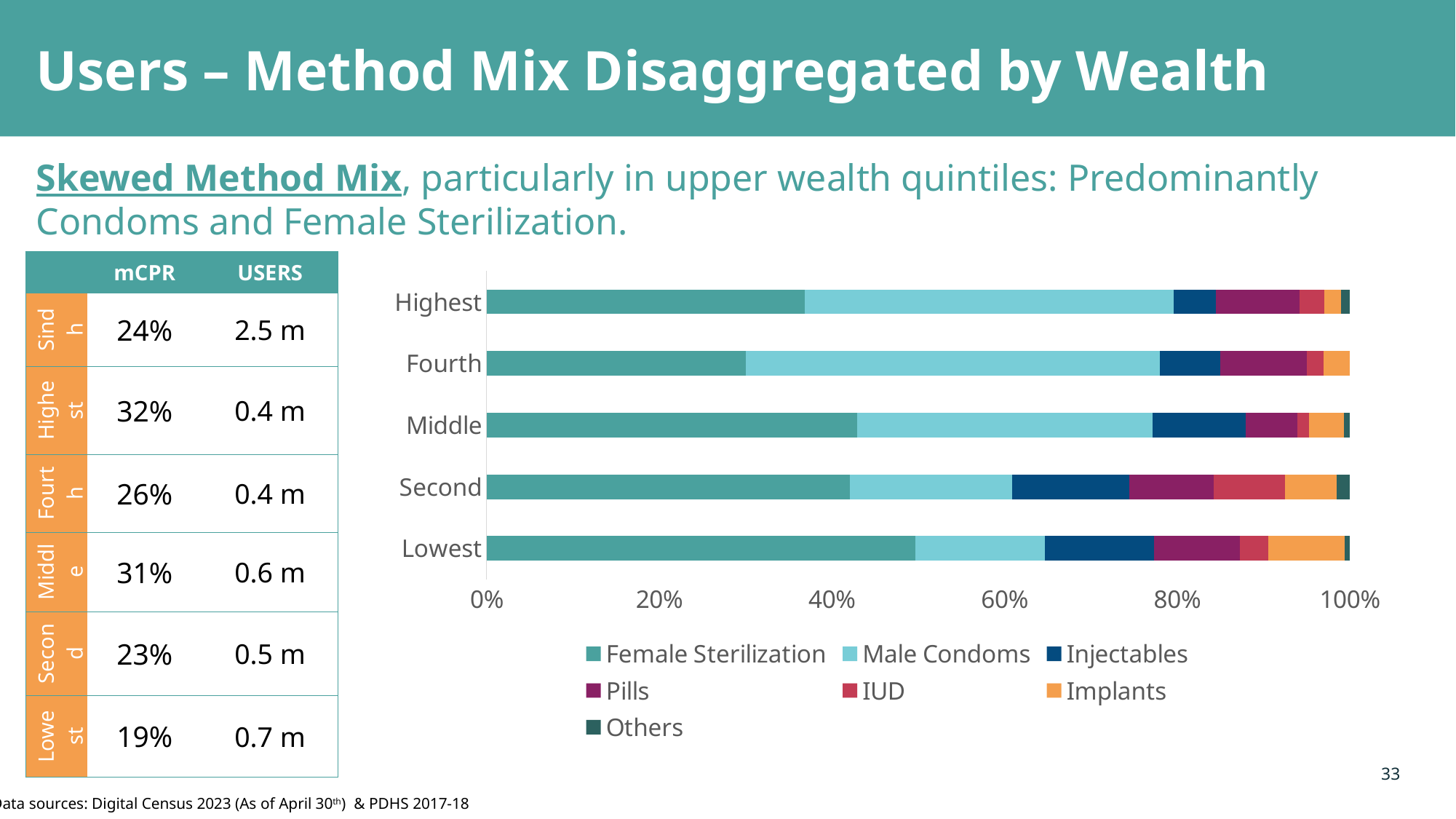
How many series does the chart legend list? 7 Which wealth quintile has the smallest Female Sterilization share? Fourth Is the Female Sterilization share for the Fourth quintile greater or less than 40%? less What kind of chart is shown on the slide? bar chart How many wealth quintile categories are plotted on the chart? 5 Which quintile has a larger Injectables share, Second or Highest? Second Is the Female Sterilization share for the Highest quintile greater or less than 40%? less Which quintile has a larger Male Condoms share, Highest or Lowest? Highest Which wealth quintile has the largest Female Sterilization share? Lowest Is the Female Sterilization share for the Lowest quintile greater or less than 40%? greater Which series is listed first in the chart legend? Female Sterilization What colour represents Implants in the chart? orange